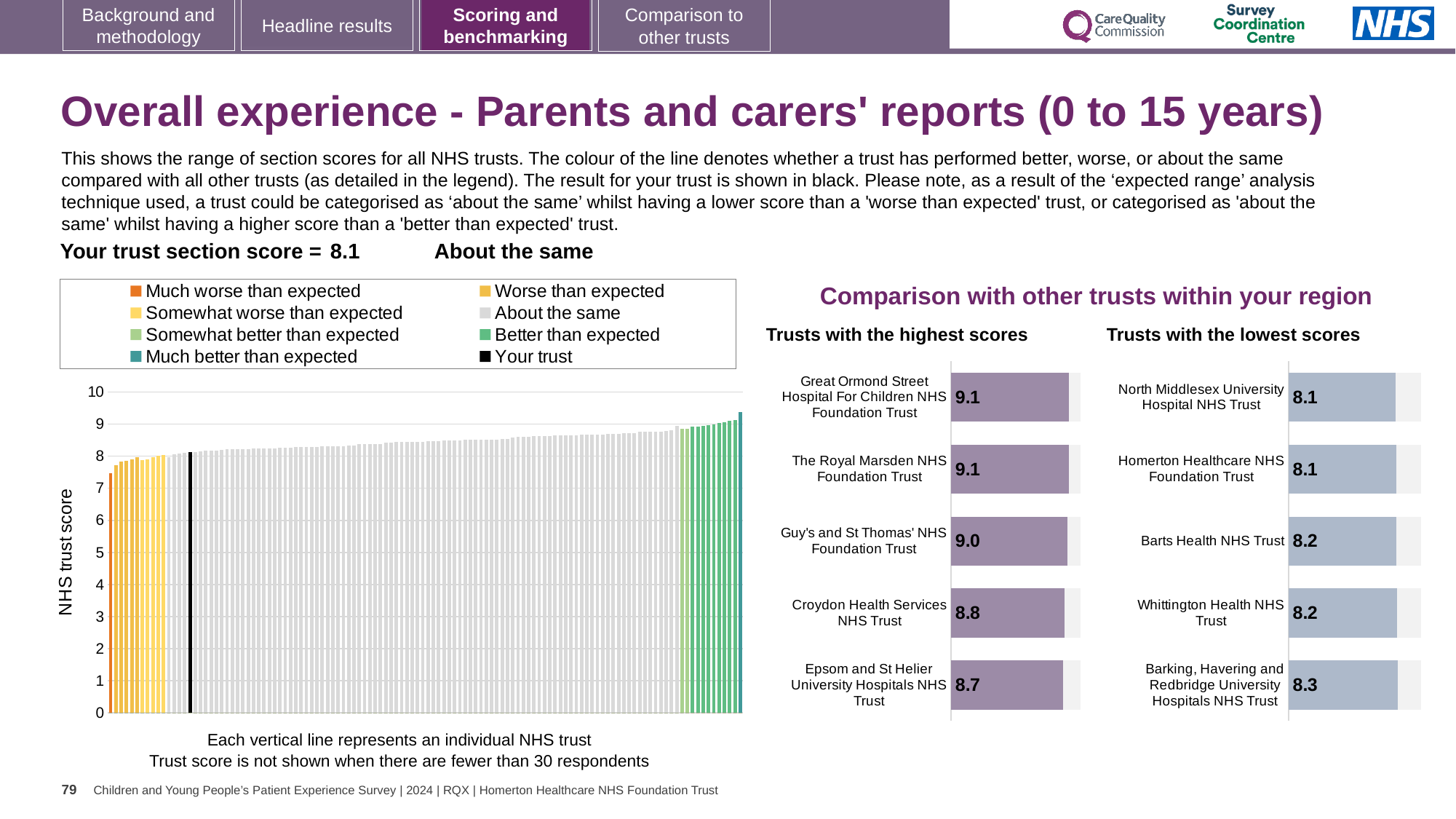
In the 'Trusts with the highest scores' chart, what is the difference between the scores of Great Ormond Street Hospital For Children NHS Foundation Trust and Epsom and St Helier University Hospitals NHS Trust? 0.4 In the 'Trusts with the lowest scores' chart, which trust has the highest score? Barking, Havering and Redbridge University Hospitals NHS Trust In the 'Trusts with the highest scores' chart, what is the score for Croydon Health Services NHS Trust? 8.8 In the large chart on the left, is the value of the highest (rightmost) bar greater or less than 9? greater In the 'Trusts with the lowest scores' chart, which has the larger score: Homerton Healthcare NHS Foundation Trust or Whittington Health NHS Trust? Whittington Health NHS Trust In the 'Trusts with the highest scores' chart, which trust has the lowest score? Epsom and St Helier University Hospitals NHS Trust In the 'Trusts with the highest scores' chart, what is the score for Guy's and St Thomas' NHS Foundation Trust? 9.0 In the large chart on the left, is the value of the lowest (leftmost) bar greater or less than 8? less How many entries does the legend of the large chart on the left list? 8 How many trusts are shown in the 'Trusts with the highest scores' chart? 5 In the 'Trusts with the lowest scores' chart, what is the score for Barking, Havering and Redbridge University Hospitals NHS Trust? 8.3 In the 'Trusts with the lowest scores' chart, what is the score for Barts Health NHS Trust? 8.2